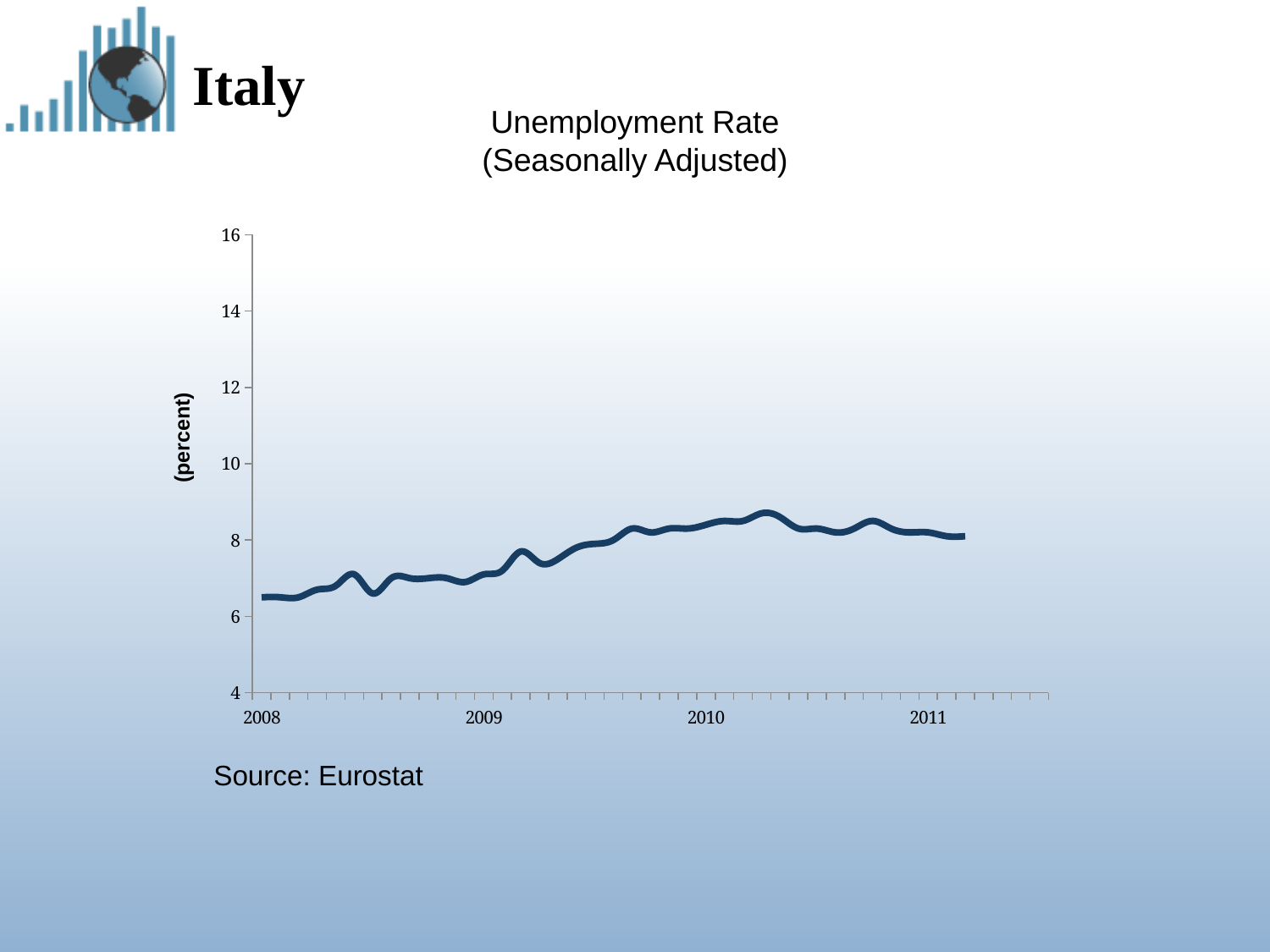
How many year labels are shown on the horizontal axis? 4 Is the unemployment rate at the start of 2010 greater or less than 8? greater Which is lower, the unemployment rate at the start of 2009 or at the start of 2011? start of 2009 What is the label on the vertical axis of the chart? (percent) What kind of chart is shown on the slide? line chart Is the unemployment rate at the start of 2011 greater or less than 8? greater Is the unemployment rate at the start of 2008 greater or less than 8? less Which is higher, the unemployment rate at the start of 2008 or at the start of 2010? start of 2010 What is the title of the chart? Unemployment Rate (Seasonally Adjusted) Overall, does the unemployment rate rise or fall from 2008 to 2011? rise